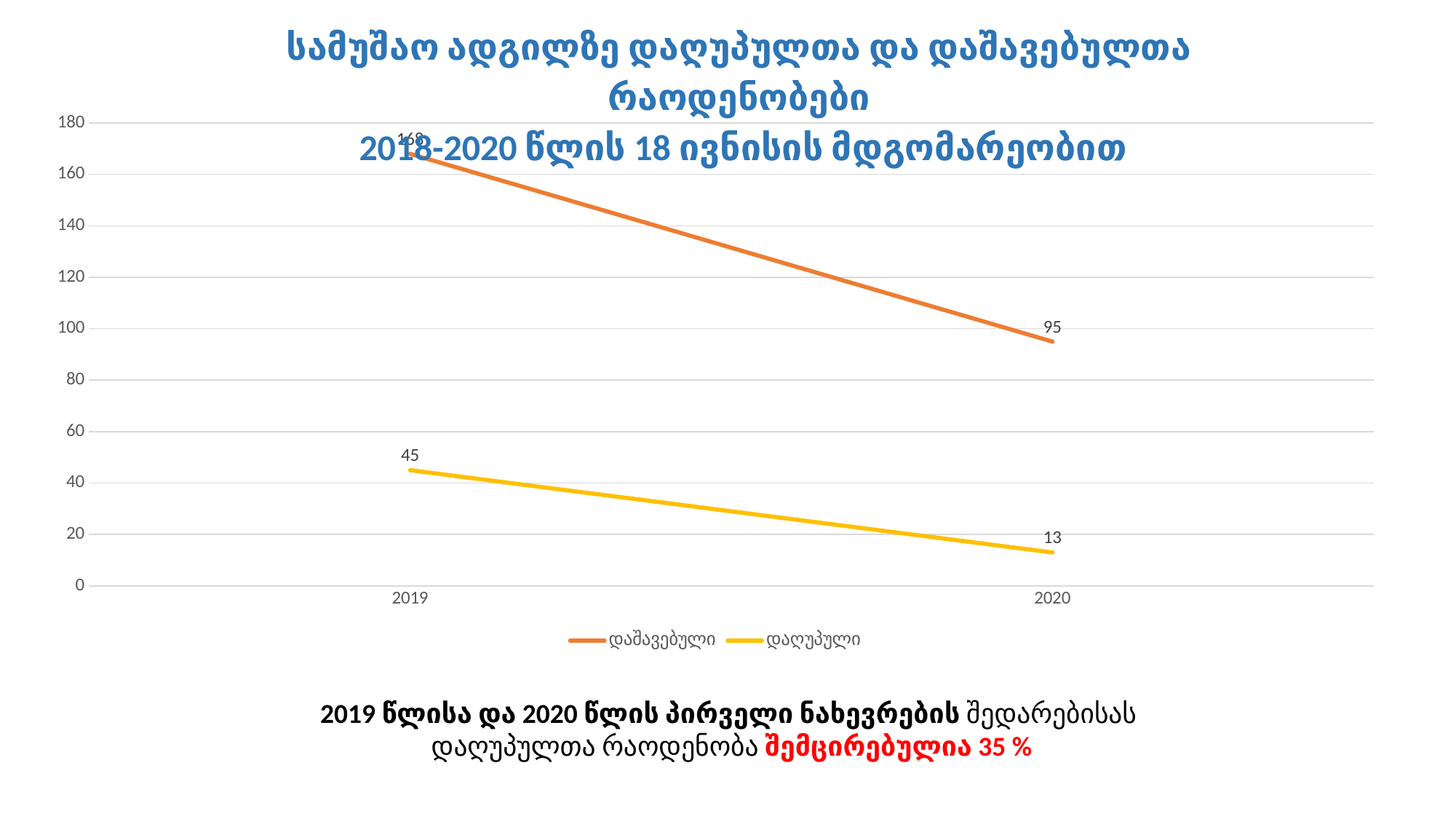
In 2020, which series has the larger value, დაშავებული or დაღუპული? დაშავებული Does the დაღუპული line rise or fall from 2019 to 2020? fall What kind of chart is shown on the slide? line chart Is the value for დაშავებული in 2019 greater or less than 160? greater By how much did the value of დაღუპული decrease from 2019 to 2020? 32 Does the დაშავებული line rise or fall from 2019 to 2020? fall How many series does the legend list? 2 How many years are shown on the x axis? 2 What is the value of დაღუპული in 2020? 13 What colour is the დაღუპული line in the legend? yellow What is the value of დაშავებული in 2020? 95 What is the value of დაღუპული in 2019? 45